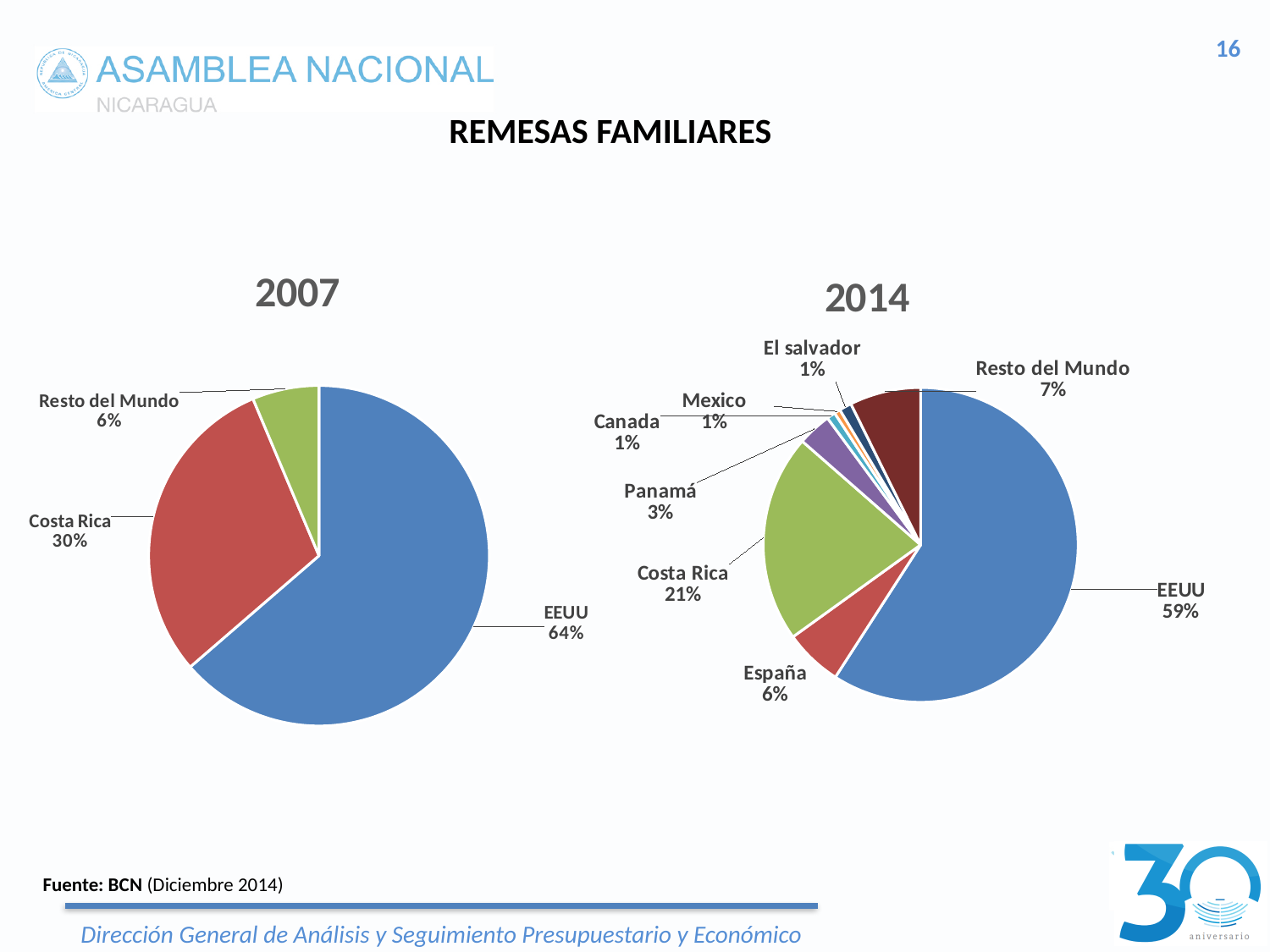
In the 2007 chart, which category has the smallest share? Resto del Mundo How many categories are shown in the 2007 chart? 3 In the 2007 chart, what share of remittances came from Costa Rica? 30% In the 2014 chart, what share of remittances came from Panamá? 3% In the 2014 chart, which category has the largest share? EEUU In the 2007 chart, what is the difference between the EEUU share and the Costa Rica share? 34 percentage points What type of chart is the 2007 chart? Pie chart In the 2014 chart, which is larger: the share for Costa Rica or the share for Resto del Mundo? Costa Rica In the 2014 chart, what share of remittances came from España? 6% In the 2014 chart, what share of remittances came from EEUU? 59% In the 2007 chart, what share of remittances came from EEUU? 64% How many categories are shown in the 2014 chart? 8